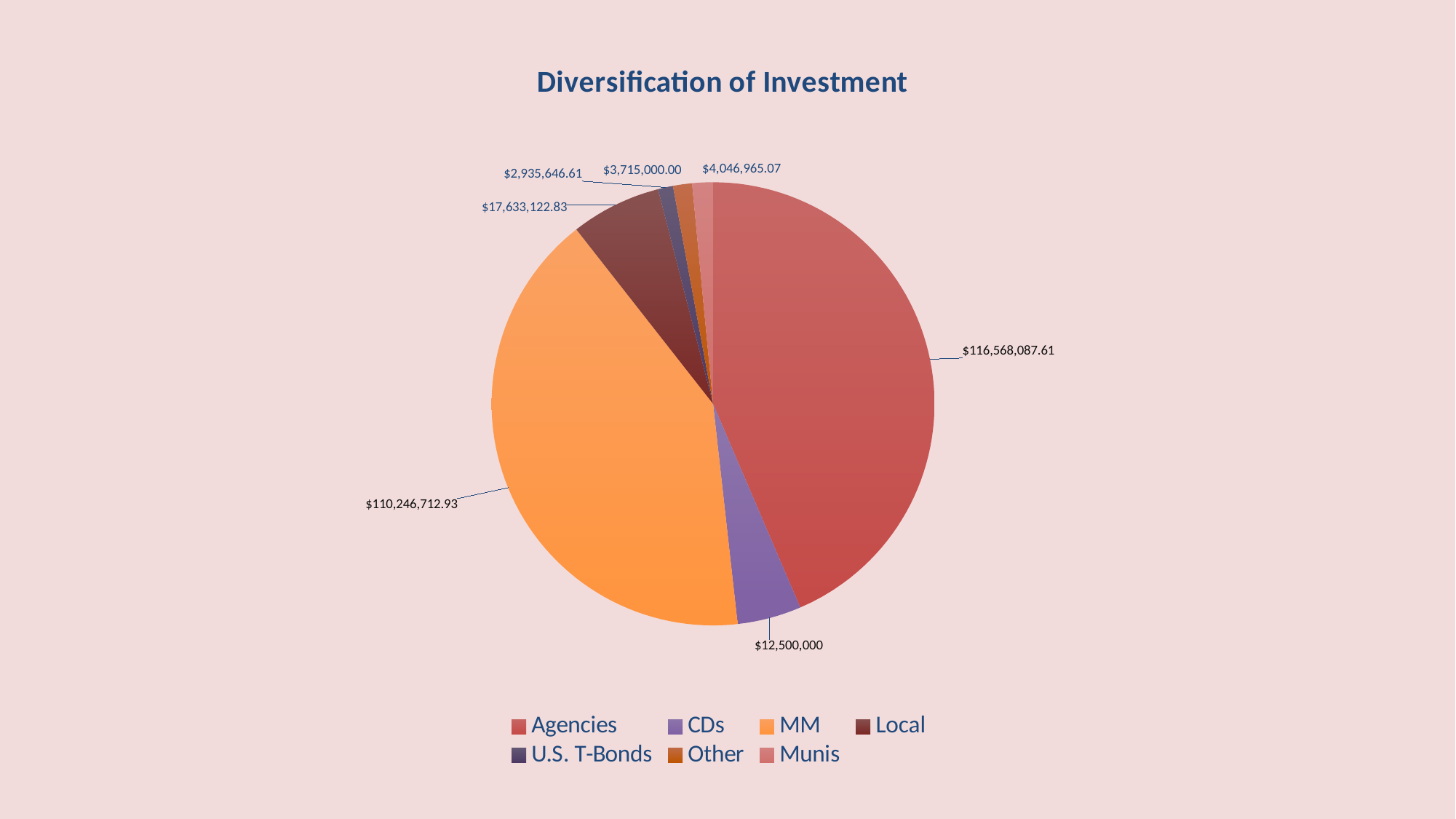
What is the value of the U.S. T-Bonds slice? $2,935,646.61 How many categories does the pie chart show? 7 What is the difference between the Agencies and MM values? $6,321,374.68 What is the value of the MM slice? $110,246,712.93 What type of chart is shown on the slide? Pie chart Which is larger, the Local slice or the CDs slice? Local Which category has the largest slice? Agencies What is the value of the Munis slice? $4,046,965.07 What is the value of the Local slice? $17,633,122.83 What is the value of the CDs slice? $12,500,000 What is the value of the Agencies slice? $116,568,087.61 Which category has the smallest slice? U.S. T-Bonds